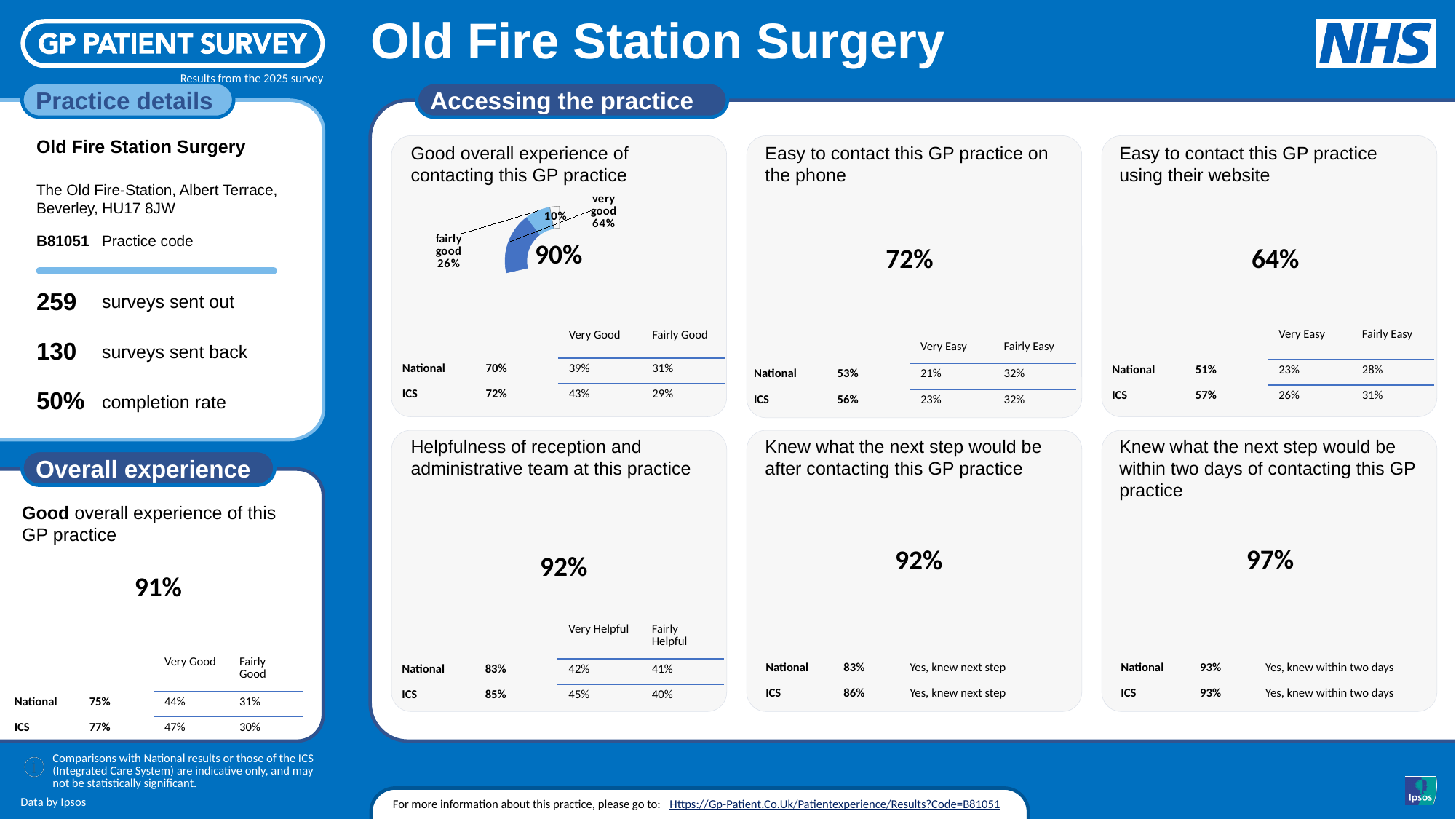
In the doughnut chart for 'Good overall experience of contacting this GP practice', what percentage is shown for 'very good'? 64% In the doughnut chart for 'Good overall experience of contacting this GP practice', what is the combined share of 'very good' and 'fairly good'? 90% In the doughnut chart for 'Good overall experience of contacting this GP practice', what percentage is shown on the smallest slice? 10% In the doughnut chart for 'Good overall experience of contacting this GP practice', which is larger, 'very good' or 'fairly good'? very good What is the title of the panel containing the doughnut chart? Good overall experience of contacting this GP practice What number is printed in the centre of the doughnut chart for 'Good overall experience of contacting this GP practice'? 90% In the doughnut chart for 'Good overall experience of contacting this GP practice', is the 'very good' share greater or less than 50%? greater In the doughnut chart for 'Good overall experience of contacting this GP practice', which labelled slice is the largest? very good In the doughnut chart for 'Good overall experience of contacting this GP practice', how many percentage points higher is 'very good' than 'fairly good'? 38% How many slices with percentage labels does the doughnut chart for 'Good overall experience of contacting this GP practice' have? 3 In the doughnut chart for 'Good overall experience of contacting this GP practice', what percentage is shown for 'fairly good'? 26% What kind of chart is used in the 'Good overall experience of contacting this GP practice' panel? doughnut chart